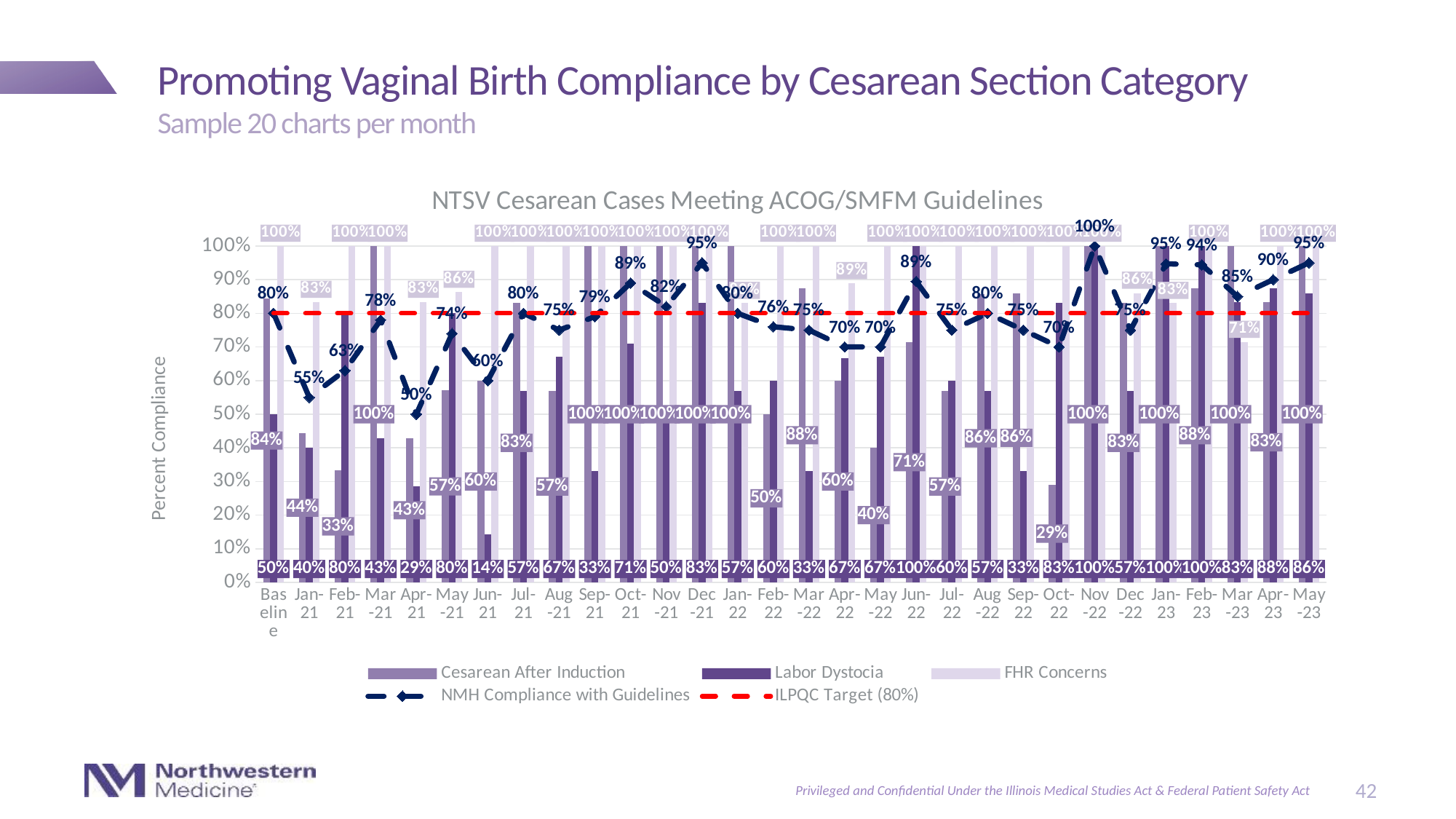
What kind of chart is shown on the slide? Bar chart with a line Which is higher, NMH Compliance with Guidelines in Oct-21 or in Nov-21? Oct-21 What is the title of the chart? NTSV Cesarean Cases Meeting ACOG/SMFM Guidelines What is the difference between NMH Compliance with Guidelines in Dec-21 and Jan-21? 40 percentage points In which period is NMH Compliance with Guidelines lowest? Apr-21 How many series does the legend list? 5 How many categories (time periods) are shown on the x axis? 30 What is the NMH Compliance with Guidelines value for Nov-22? 100% What is the NMH Compliance with Guidelines value for Apr-21? 50% What value does the ILPQC Target line represent? 80% Does NMH Compliance with Guidelines rise or fall from Mar-23 to May-23? Rise What is the Labor Dystocia value for Jun-21? 14%